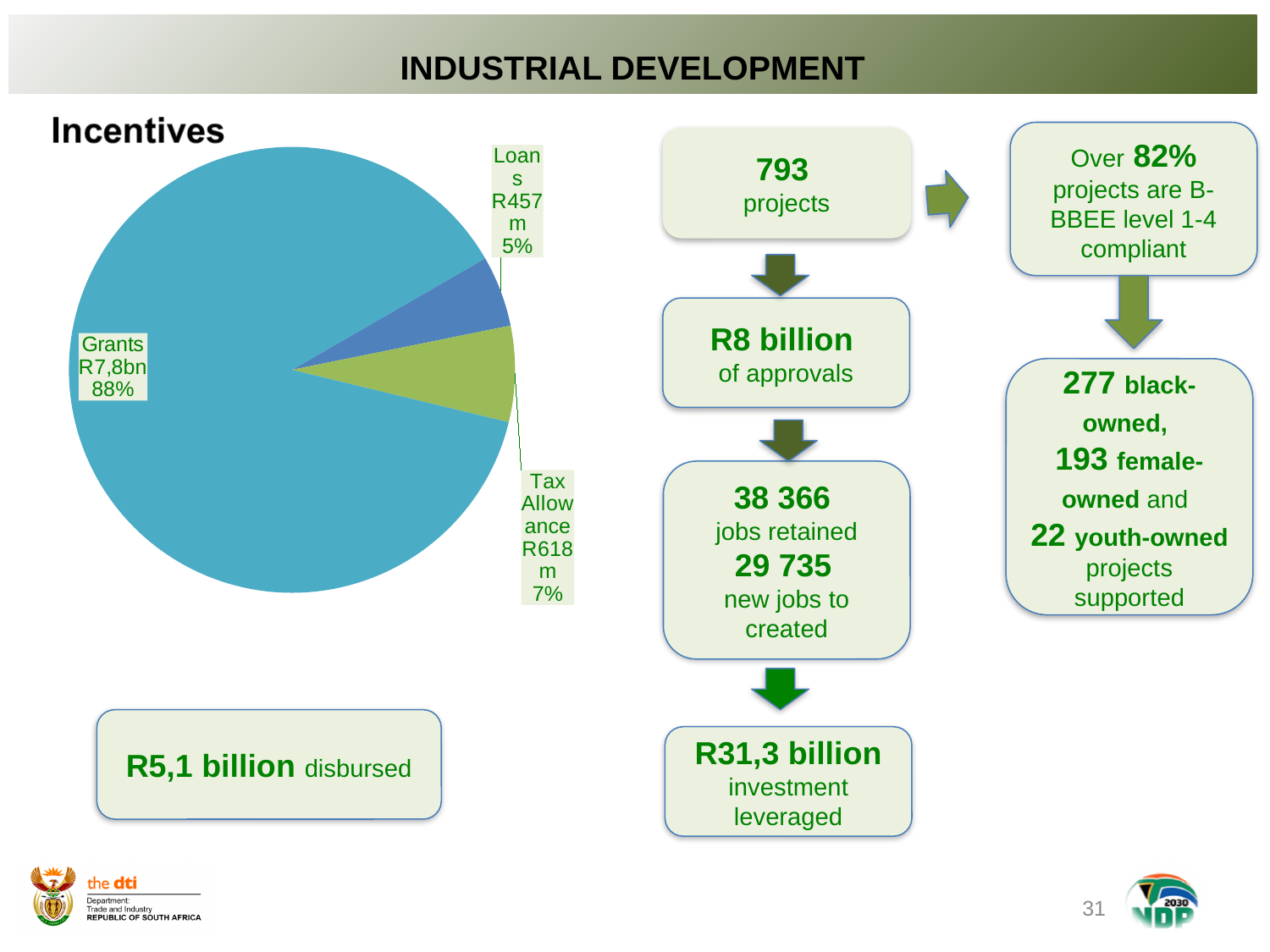
What share of the Incentives pie chart is Tax Allowance? 7% In the Incentives pie chart, how much larger is the Tax Allowance value than the Loans value? R161m In the Incentives pie chart, by how many percentage points does the Grants share exceed the Tax Allowance share? 81 percentage points What value is shown for Tax Allowance in the Incentives pie chart? R618m Which category has the largest slice in the Incentives pie chart? Grants What share of the Incentives pie chart is Grants? 88% What value is shown for Loans in the Incentives pie chart? R457m What kind of chart is shown under the heading "Incentives"? Pie chart Which category has the smallest slice in the Incentives pie chart? Loans How many slices does the Incentives pie chart have? 3 What value is shown for Grants in the Incentives pie chart? R7,8bn In the Incentives pie chart, which is larger, Tax Allowance or Loans? Tax Allowance